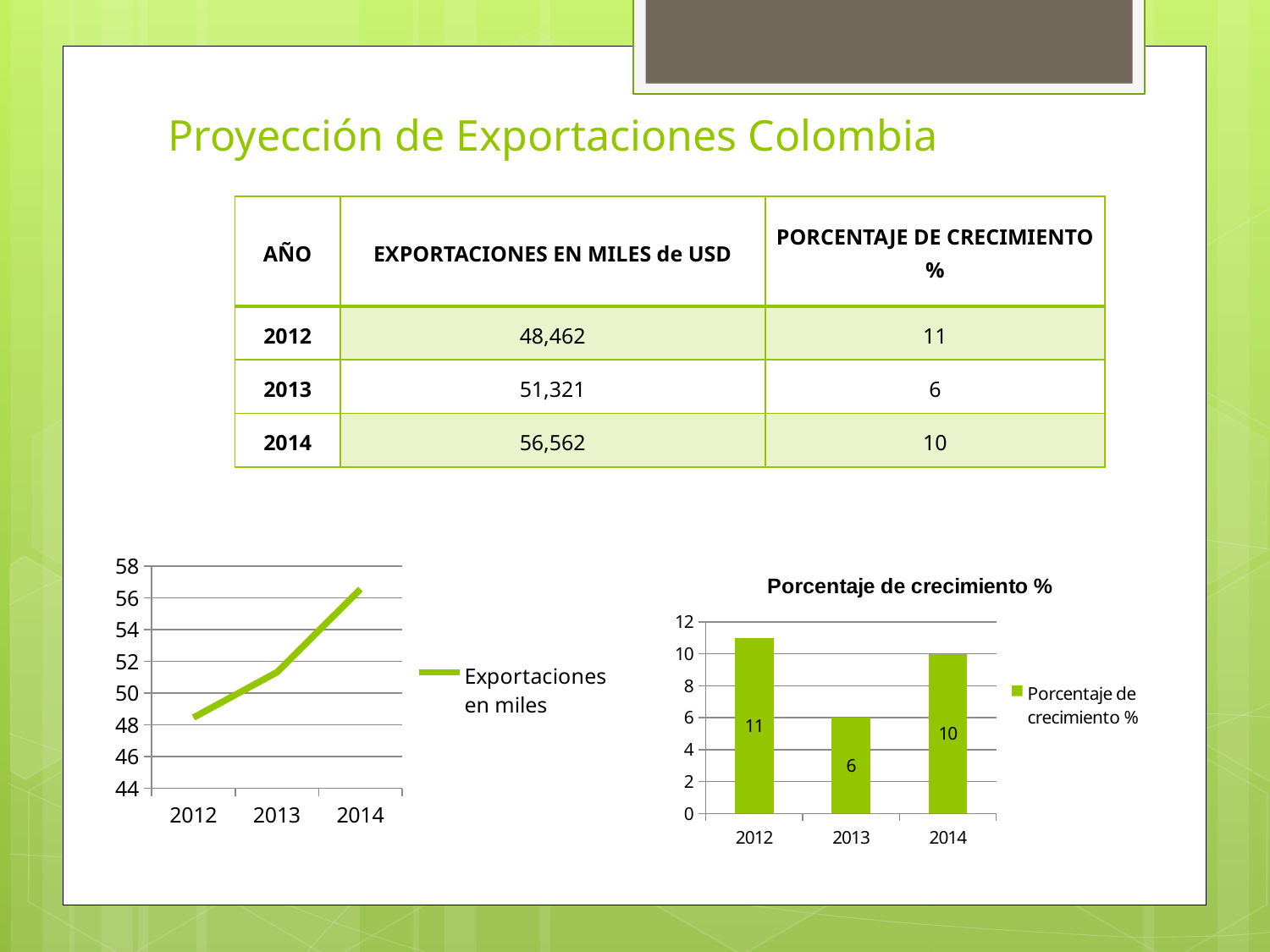
In the chart titled 'Porcentaje de crecimiento %', what is the difference between the values for 2012 and 2013? 5 In the chart titled 'Porcentaje de crecimiento %', what is the value for 2013? 6 In the chart titled 'Porcentaje de crecimiento %', what is the value for 2014? 10 In the chart titled 'Porcentaje de crecimiento %', how many years are shown on the x axis? 3 In the chart on the left of the slide, is the value for 2014 greater or less than 56? greater In the chart on the left of the slide, do the values rise or fall from 2012 to 2014? rise What type of chart is the chart on the left of the slide? line chart In the chart on the left of the slide, what series name does the legend show? Exportaciones en miles In the chart titled 'Porcentaje de crecimiento %', which year has the lowest value? 2013 In the chart titled 'Porcentaje de crecimiento %', what is the value for 2012? 11 What type of chart is the chart titled 'Porcentaje de crecimiento %'? bar chart In the chart titled 'Porcentaje de crecimiento %', which year has the highest value? 2012